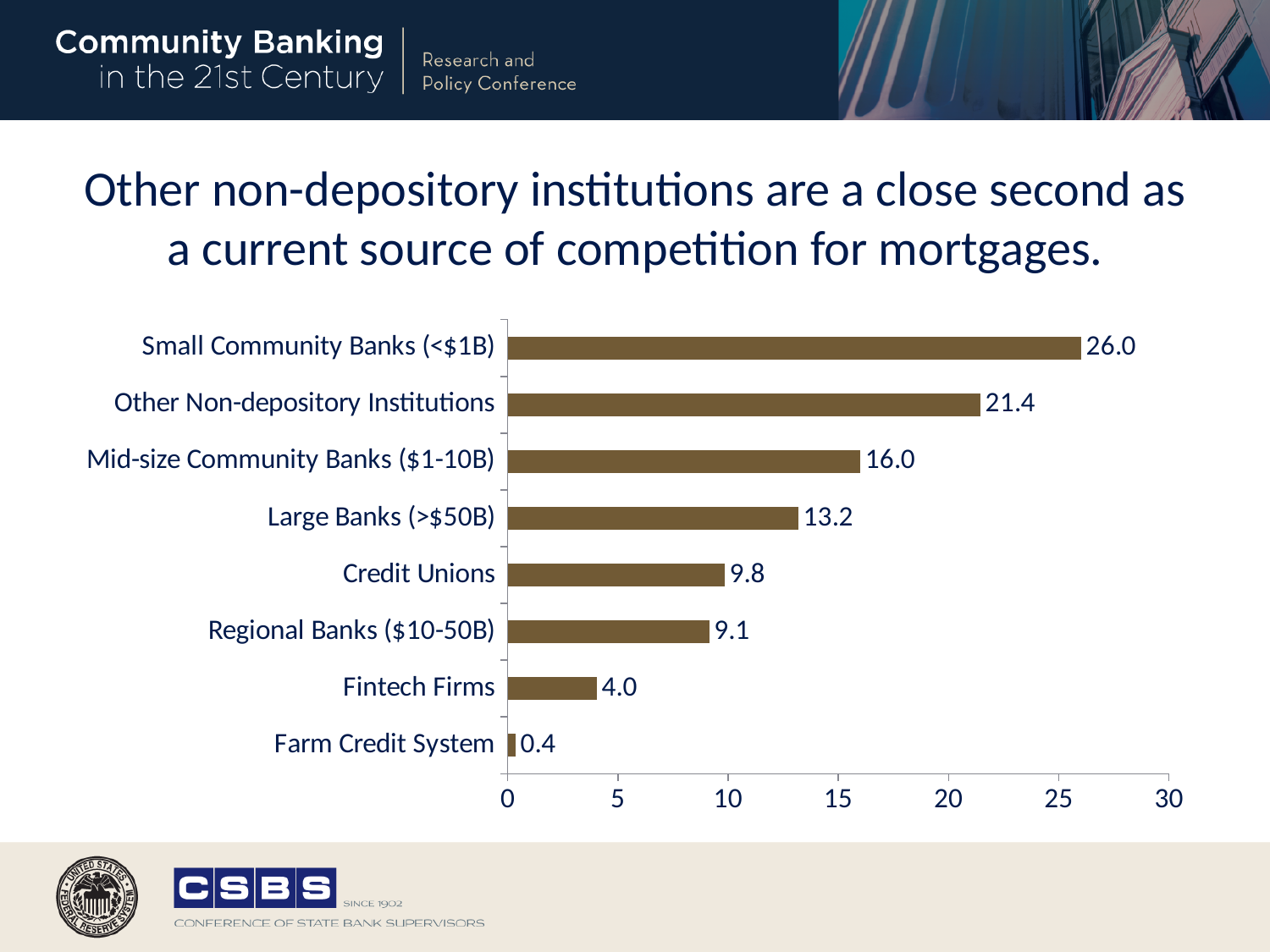
Which category has the highest value? Small Community Banks (<$1B) Which is larger, the value for Large Banks (>$50B) or the value for Regional Banks ($10-50B)? Large Banks (>$50B) How many categories are shown in the chart? 8 What is the value for Credit Unions? 9.8 What kind of chart is shown on the slide? bar chart Is the value for Mid-size Community Banks ($1-10B) greater or less than 15? greater What is the difference between the values for Fintech Firms and Farm Credit System? 3.6 What is the value for Small Community Banks (<$1B)? 26.0 Which category has the lowest value? Farm Credit System What is the difference between the values for Small Community Banks (<$1B) and Other Non-depository Institutions? 4.6 What is the value for Other Non-depository Institutions? 21.4 What is the value for Farm Credit System? 0.4